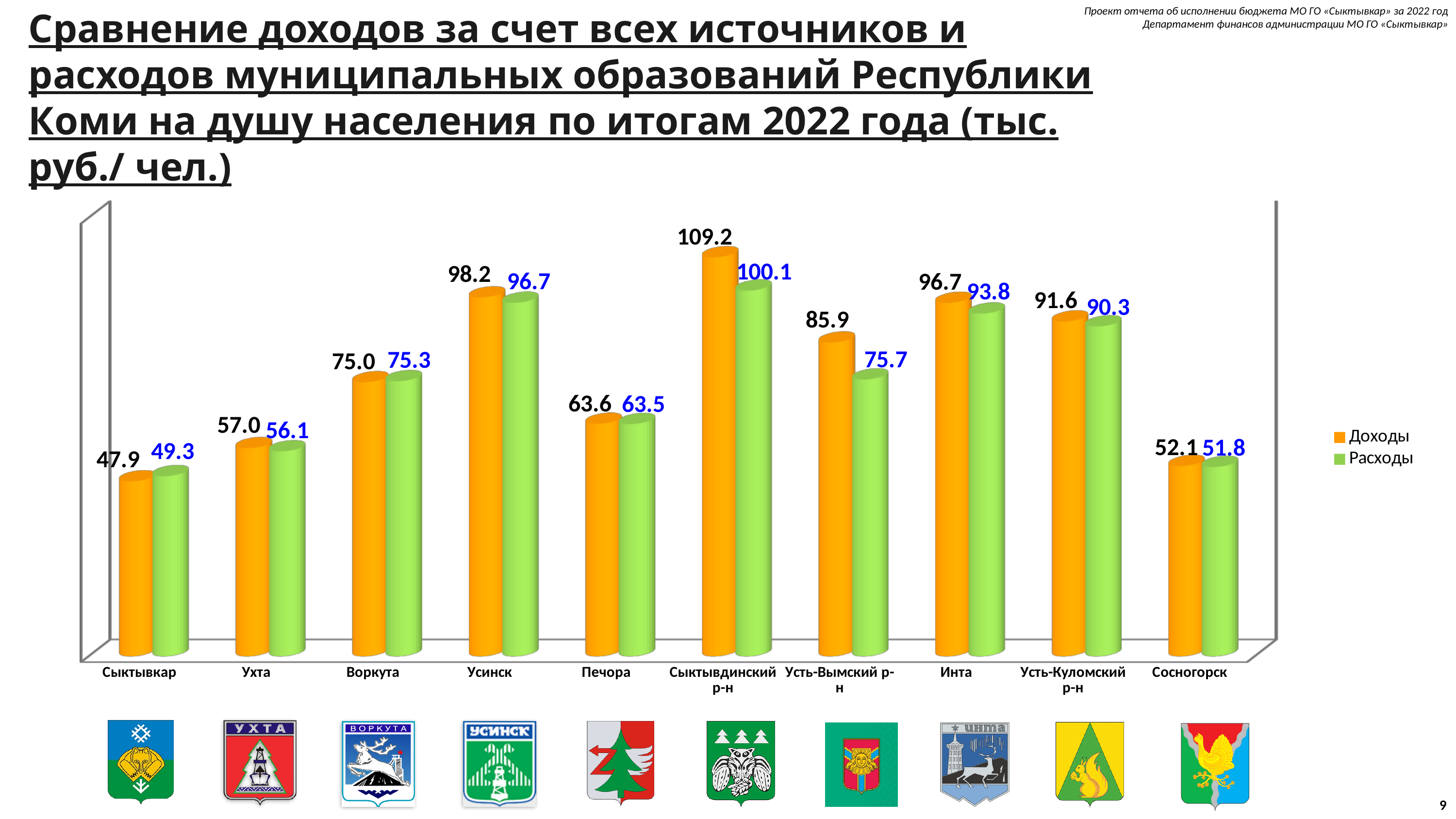
What is the difference between Доходы and Расходы for Сыктывдинский р-н? 9.1 What is the value of Доходы for Инта? 96.7 How many categories (municipalities) are shown on the x axis? 10 Which category has the lowest Расходы value? Сыктывкар Which is larger: Расходы for Ухта or Расходы for Сосногорск? Ухта What is the value of Расходы for Усть-Вымский р-н? 75.7 What is the value of Доходы for Сыктывкар? 47.9 Which category has the highest Доходы value? Сыктывдинский р-н What kind of chart is shown on the slide? Bar chart What is the difference between Доходы for Усинск and Доходы for Печора? 34.6 How many series does the legend list? 2 Which is larger for Усть-Вымский р-н: Доходы or Расходы? Доходы